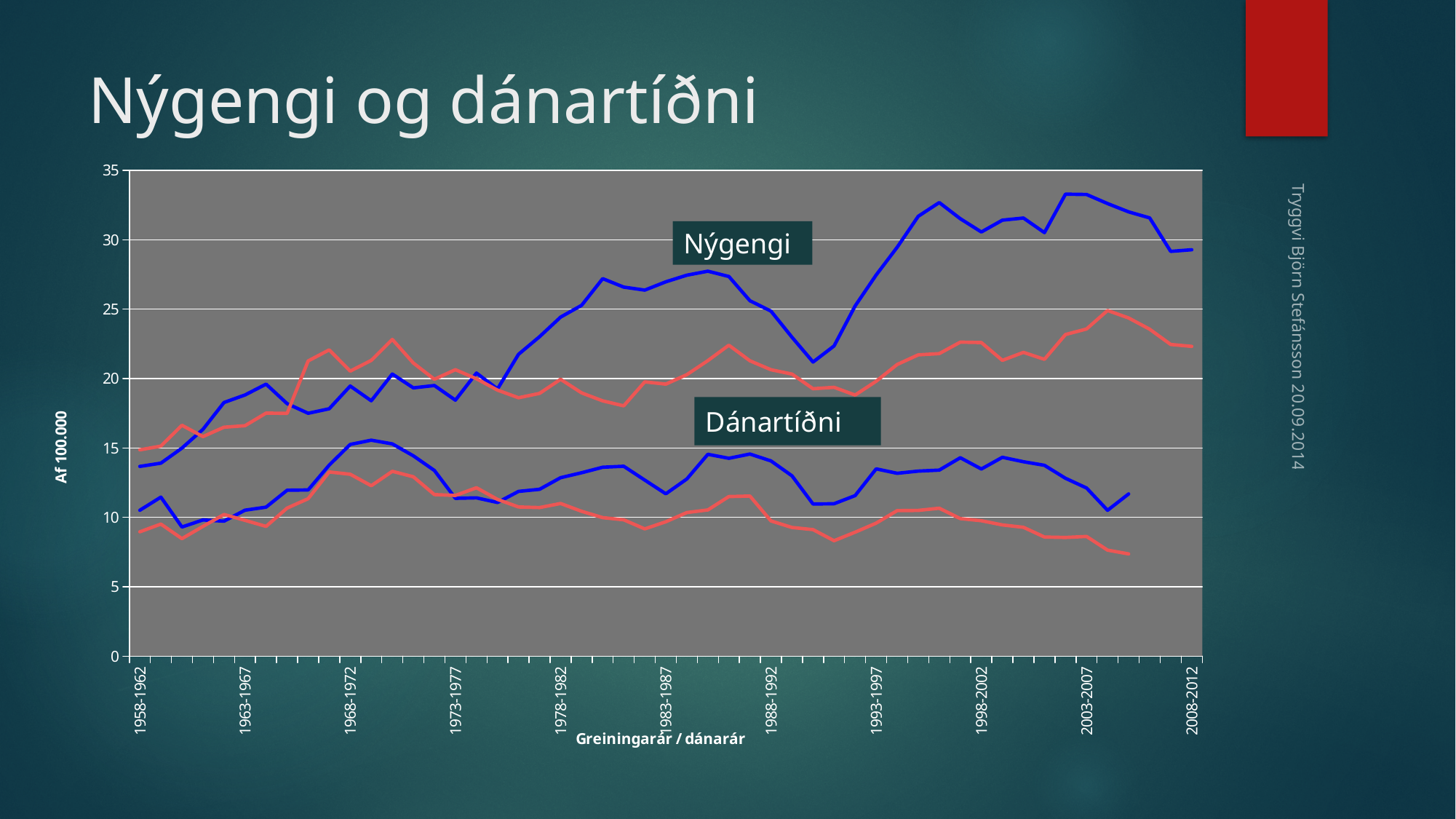
Is the value of the red Dánartíðni line at 1993-1997 greater or less than 15? less Does the blue Nýgengi line rise or fall overall from 1958-1962 to 2003-2007? rise How many period labels are shown along the x axis of the chart? 11 What is the title of the horizontal axis of the chart? Greiningarár / dánarár What kind of chart is shown on the slide? line chart What is the title of the vertical axis of the chart? Af 100.000 Is the value of the blue Nýgengi line at 1958-1962 greater or less than 10? greater Is the value of the red Nýgengi line at 1958-1962 greater or less than 10? greater At 2003-2007, which is higher: the blue Nýgengi line or the red Nýgengi line? the blue Nýgengi line